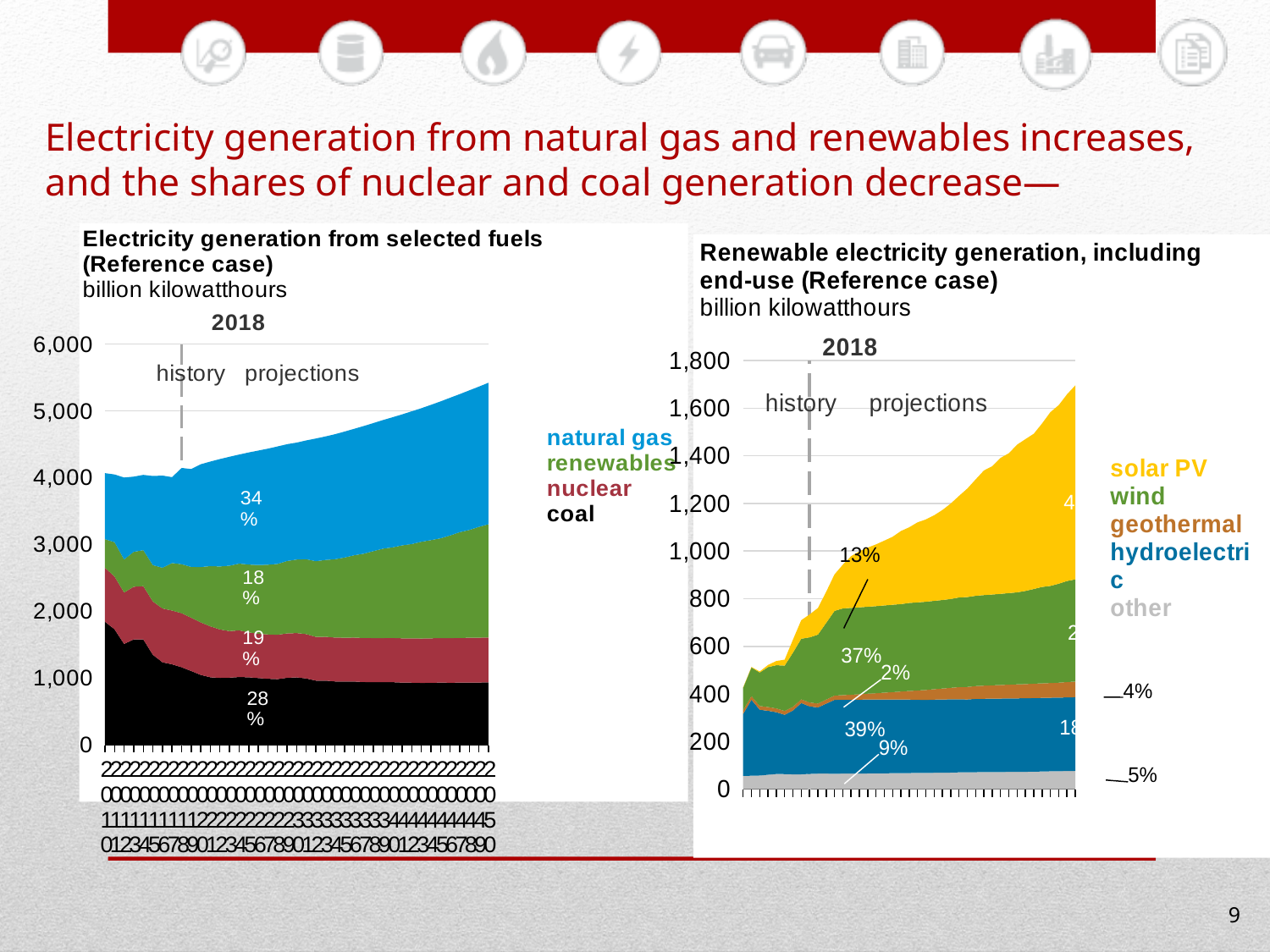
In the left chart, 'Electricity generation from selected fuels', which fuel has the largest share in 2018? natural gas What kind of chart is the left chart, 'Electricity generation from selected fuels (Reference case)'? stacked area chart In the right chart, 'Renewable electricity generation, including end-use', what share does solar PV have in 2018? 13% In the right chart, 'Renewable electricity generation, including end-use', what share does hydroelectric have in 2018? 39% In the left chart, 'Electricity generation from selected fuels', what share of generation does natural gas have in 2018? 34% How many series does the legend of the left chart, 'Electricity generation from selected fuels', list? 4 How many series does the legend of the right chart, 'Renewable electricity generation, including end-use', list? 5 In the left chart, 'Electricity generation from selected fuels', what share of generation does coal have in 2018? 28% In the left chart, 'Electricity generation from selected fuels', what is the difference between the 2018 shares of natural gas and coal? 6% In the right chart, 'Renewable electricity generation, including end-use', is the total renewable generation in 2018 greater or less than 1,000 billion kilowatthours? less In the right chart, 'Renewable electricity generation, including end-use', which source has the smallest share in 2018? geothermal In the left chart, 'Electricity generation from selected fuels', what share of generation does nuclear have in 2018? 19%